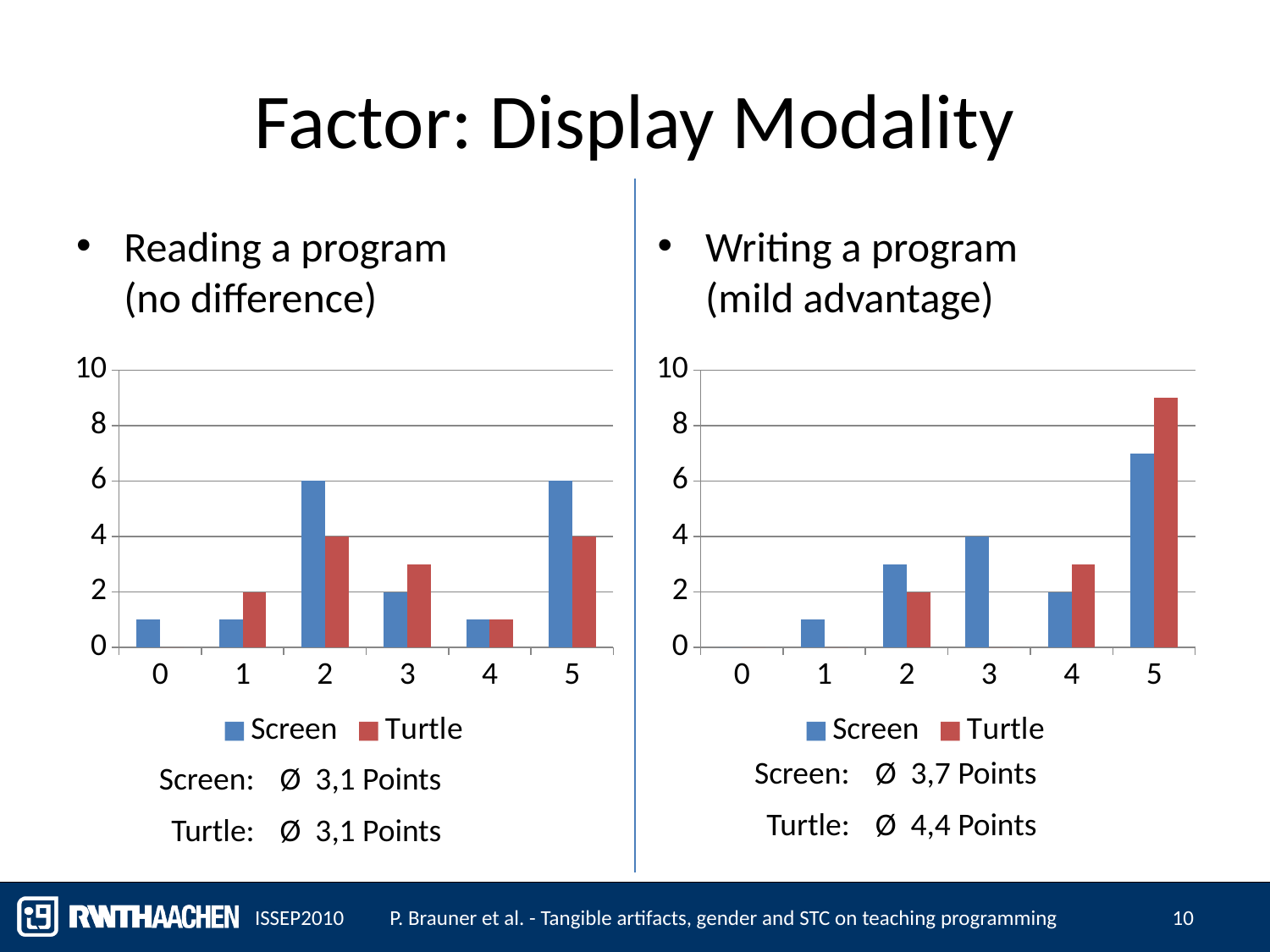
In the right chart (Writing a program), for which category is the Turtle value highest? 5 In the left chart (Reading a program), what is the Screen value for category 2? 6 In the right chart (Writing a program), which series has the larger value for category 5, Screen or Turtle? Turtle In the left chart (Reading a program), what is the Turtle value for category 1? 2 How many categories are shown on the x axis of the left chart (Reading a program)? 6 What kind of chart is the left chart (Reading a program)? bar chart In the right chart (Writing a program), what is the Screen value for category 4? 2 In the left chart (Reading a program), what is the difference between the Screen and Turtle values for category 2? 2 In the left chart (Reading a program), what is the Turtle value for category 2? 4 In the right chart (Writing a program), is the Turtle value for category 5 greater or less than 8? greater How many series does the legend of the right chart (Writing a program) list? 2 In the right chart (Writing a program), what is the Screen value for category 3? 4